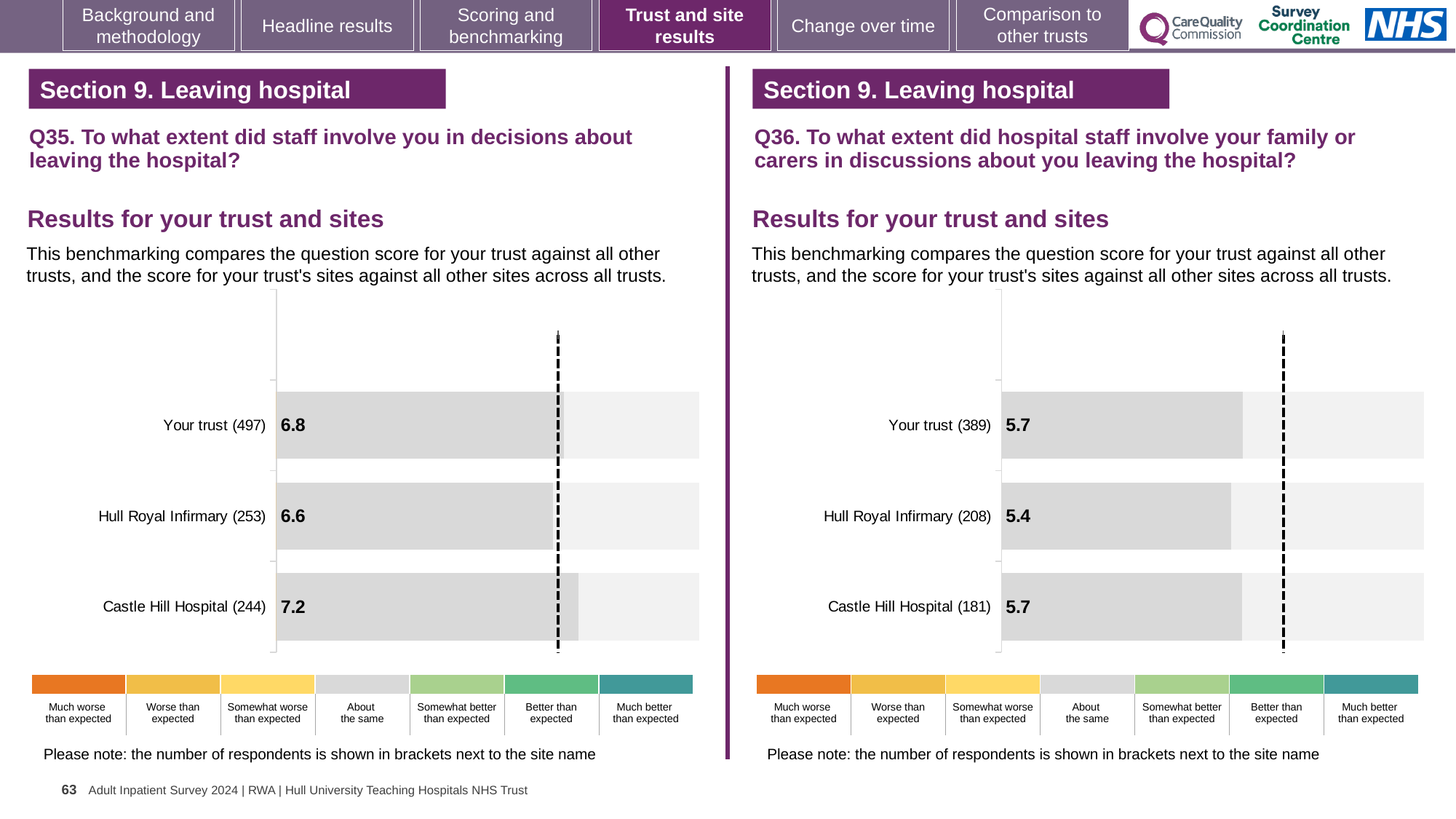
In the Q35 chart on the left, which site or trust has the highest score? Castle Hill Hospital In the Q36 chart on the right, which site or trust has the lowest score? Hull Royal Infirmary In the Q35 chart on the left, which has the larger score, Your trust or Hull Royal Infirmary? Your trust In the Q36 chart on the right, what is the score for Your trust? 5.7 In the Q35 chart on the left, what is the score for Castle Hill Hospital? 7.2 How many bars are plotted in the Q36 chart on the right? 3 What kind of chart is used in the Q35 chart on the left? Bar chart In the Q36 chart on the right, what is the difference between the scores for Your trust and Hull Royal Infirmary? 0.3 In the Q35 chart on the left, what is the score for Your trust? 6.8 In the Q36 chart on the right, what is the score for Hull Royal Infirmary? 5.4 In the Q35 chart on the left, how many respondents are shown in brackets for Castle Hill Hospital? 244 In the Q35 chart on the left, what is the difference between the scores for Castle Hill Hospital and Hull Royal Infirmary? 0.6